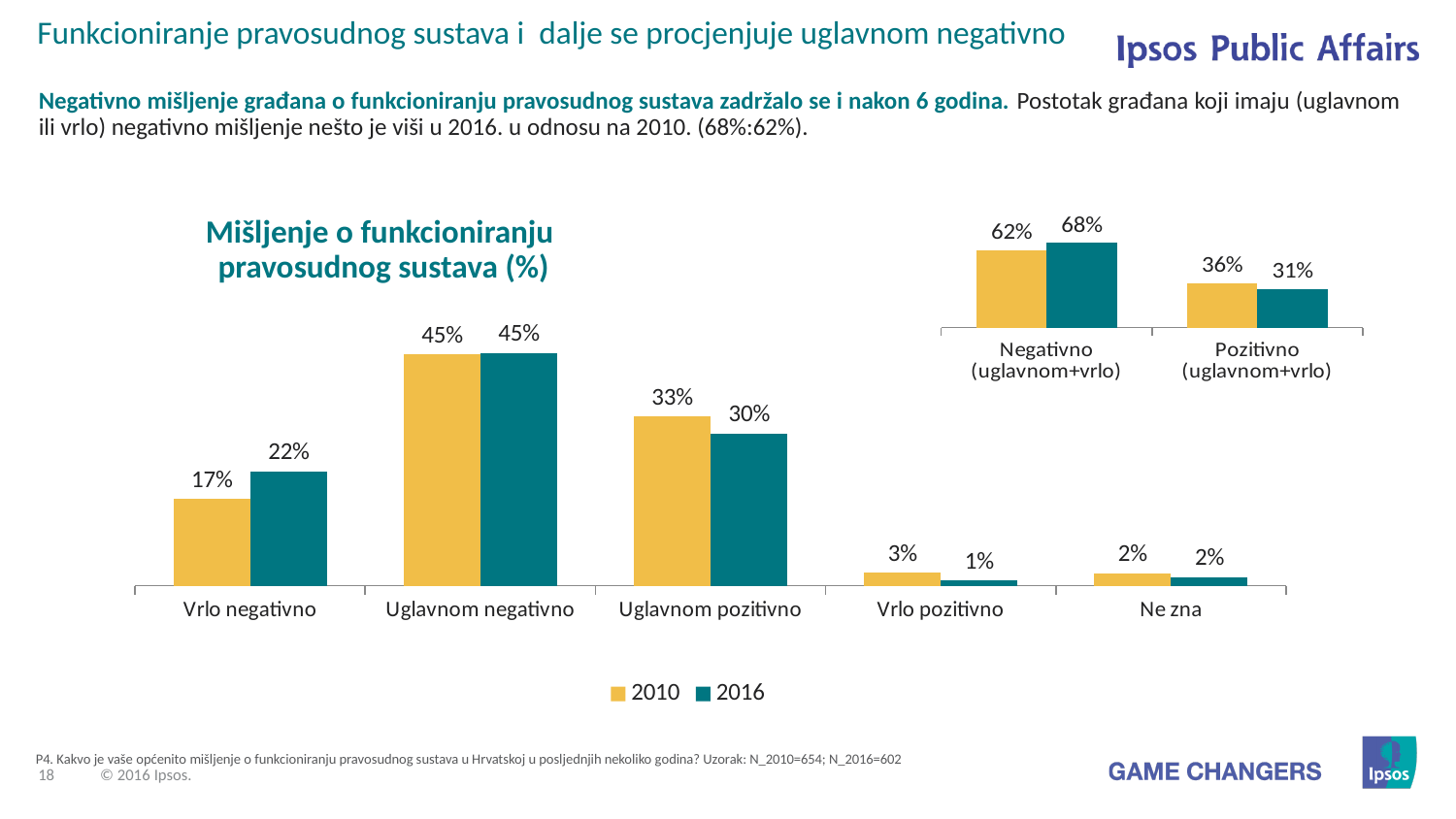
In the chart titled 'Mišljenje o funkcioniranju pravosudnog sustava (%)', which series is shown in yellow according to the legend? 2010 How many categories are shown on the x axis of the chart titled 'Mišljenje o funkcioniranju pravosudnog sustava (%)'? 5 In the chart titled 'Mišljenje o funkcioniranju pravosudnog sustava (%)', what is the value for 'Uglavnom pozitivno' in 2010? 33% In the small chart at the top right of the slide, what is the value for 'Negativno (uglavnom+vrlo)' in 2016? 68% In the chart titled 'Mišljenje o funkcioniranju pravosudnog sustava (%)', what is the difference between the 2016 and 2010 values for 'Vrlo negativno'? 5% How many series does the legend of the chart titled 'Mišljenje o funkcioniranju pravosudnog sustava (%)' list? 2 In the small chart at the top right of the slide, what is the difference between the 2010 and 2016 values for 'Pozitivno (uglavnom+vrlo)'? 5% In the chart titled 'Mišljenje o funkcioniranju pravosudnog sustava (%)', which category has the highest value for 2016? Uglavnom negativno In the chart titled 'Mišljenje o funkcioniranju pravosudnog sustava (%)', which is larger for 'Uglavnom pozitivno': the 2010 value or the 2016 value? 2010 In the chart titled 'Mišljenje o funkcioniranju pravosudnog sustava (%)', what is the value for 'Vrlo negativno' in 2016? 22% In the chart titled 'Mišljenje o funkcioniranju pravosudnog sustava (%)', which category has the lowest value for 2016? Vrlo pozitivno What type of chart is the chart titled 'Mišljenje o funkcioniranju pravosudnog sustava (%)'? Bar chart